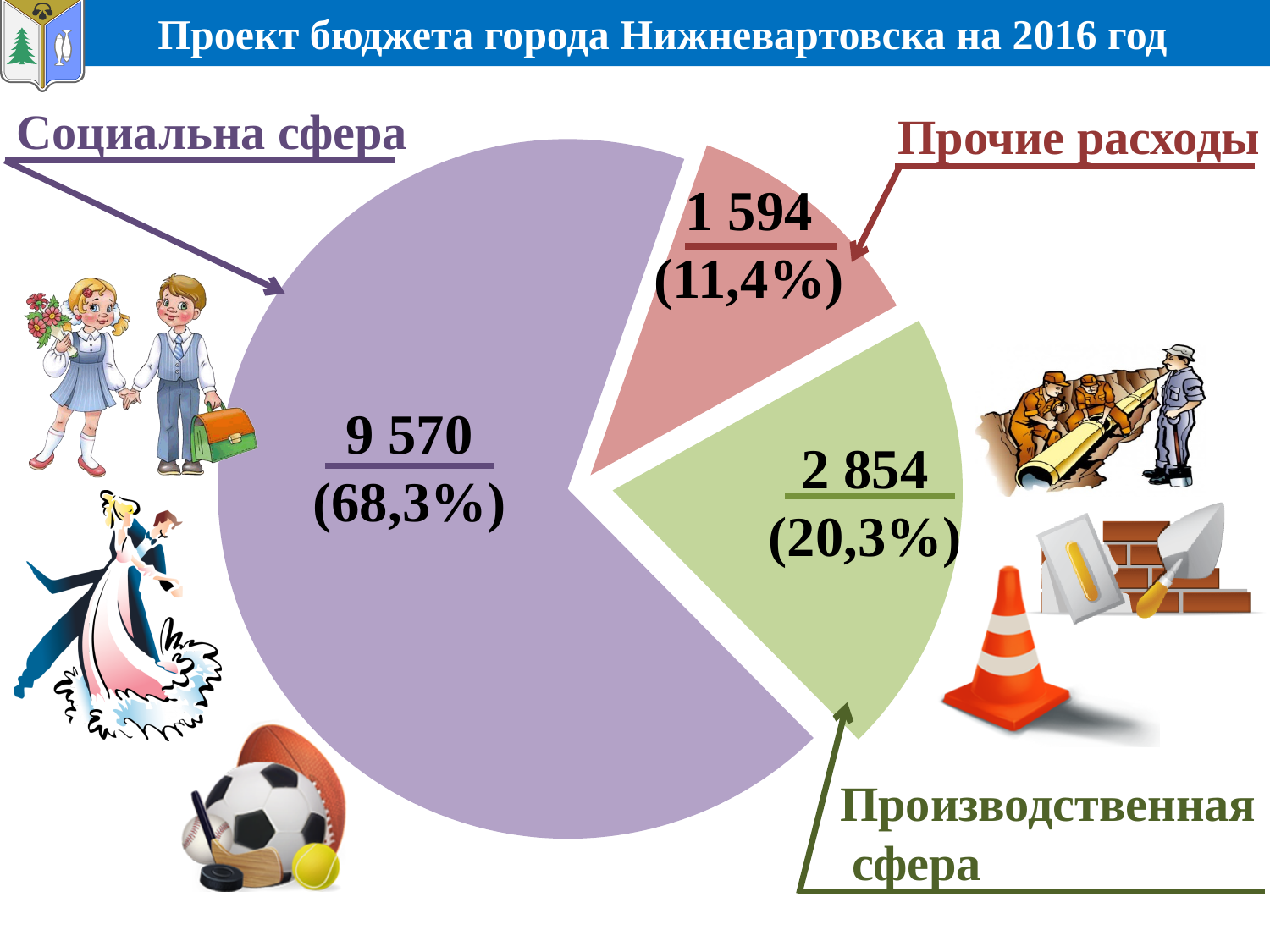
Which is larger, the value for Производственная сфера or the value for Прочие расходы? Производственная сфера What share of the pie does Производственная сфера take? 20,3% Which category has the smallest slice of the pie? Прочие расходы What share of the pie does Социальна сфера take? 68,3% What value is shown for the Социальна сфера slice? 9 570 What share of the pie does Прочие расходы take? 11,4% How many slices does the pie chart have? 3 Which category has the largest slice of the pie? Социальна сфера What value is shown for the Прочие расходы slice? 1 594 What is the difference between the values for Социальна сфера and Производственная сфера? 6 716 What value is shown for the Производственная сфера slice? 2 854 What is the difference between the values for Производственная сфера and Прочие расходы? 1 260